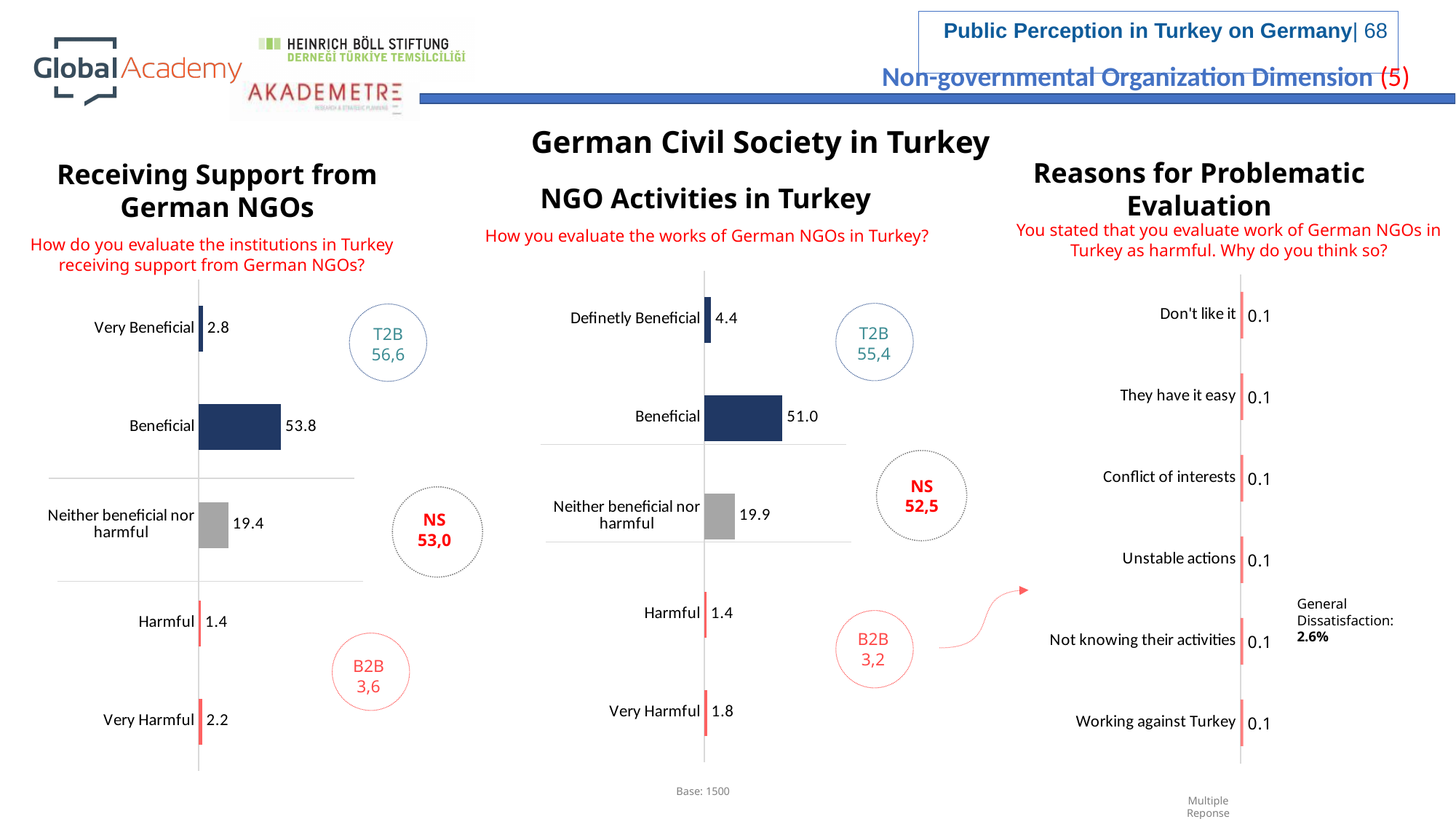
In the 'NGO Activities in Turkey' chart, what is the T2B value shown in the circle? 55,4 In the 'Reasons for Problematic Evaluation' chart, how many categories are plotted? 6 In the 'Reasons for Problematic Evaluation' chart, what is the value for Working against Turkey? 0.1 In the 'NGO Activities in Turkey' chart, which is larger, Definetly Beneficial or Very Harmful? Definetly Beneficial In the 'Receiving Support from German NGOs' chart, what is the value for Beneficial? 53.8 In the 'NGO Activities in Turkey' chart, how many categories are plotted? 5 In the 'Receiving Support from German NGOs' chart, what is the difference between Beneficial and Neither beneficial nor harmful? 34.4 In the 'Receiving Support from German NGOs' chart, which category has the lowest value? Harmful What kind of chart is the 'Receiving Support from German NGOs' chart? Bar chart In the 'Receiving Support from German NGOs' chart, which category has the highest value? Beneficial In the 'NGO Activities in Turkey' chart, what is the difference between Beneficial and Definetly Beneficial? 46.6 In the 'NGO Activities in Turkey' chart, what is the value for Neither beneficial nor harmful? 19.9